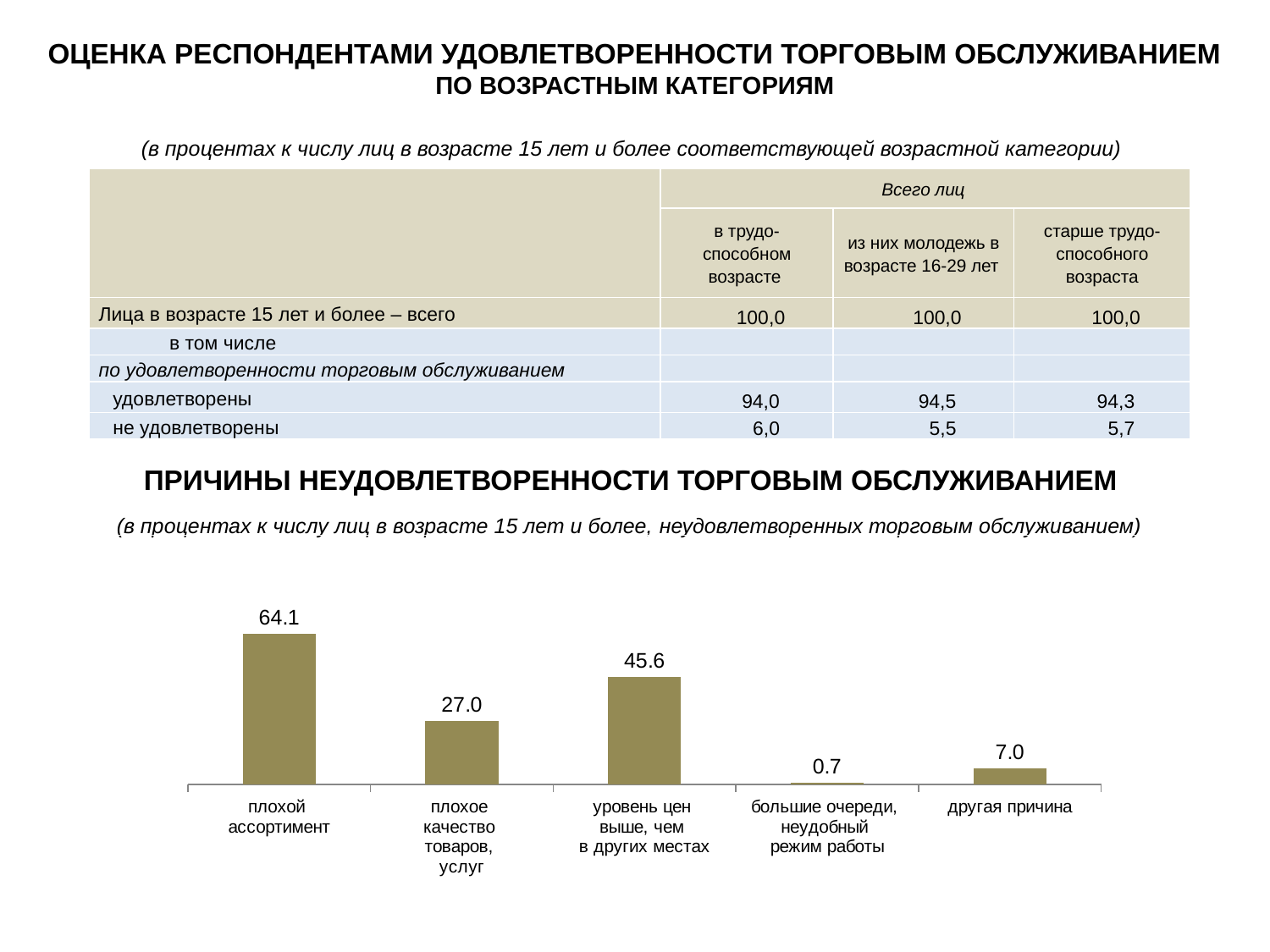
What kind of chart is shown under the heading 'ПРИЧИНЫ НЕУДОВЛЕТВОРЕННОСТИ ТОРГОВЫМ ОБСЛУЖИВАНИЕМ'? bar chart What is the difference between the values for 'плохой ассортимент' and 'уровень цен выше, чем в других местах' in the bar chart? 18.5 Which category has the highest value in the bar chart? плохой ассортимент What is the value for 'другая причина' in the bar chart? 7.0 What is the difference between the values for 'плохое качество товаров, услуг' and 'другая причина' in the bar chart? 20.0 What is the title of the bar chart on the slide? ПРИЧИНЫ НЕУДОВЛЕТВОРЕННОСТИ ТОРГОВЫМ ОБСЛУЖИВАНИЕМ Which is larger in the bar chart: 'плохое качество товаров, услуг' or 'уровень цен выше, чем в других местах'? уровень цен выше, чем в других местах What is the value for 'большие очереди, неудобный режим работы' in the bar chart? 0.7 What is the value for 'уровень цен выше, чем в других местах' in the bar chart? 45.6 What is the value for 'плохой ассортимент' in the bar chart? 64.1 Which category has the lowest value in the bar chart? большие очереди, неудобный режим работы How many categories are shown in the bar chart? 5